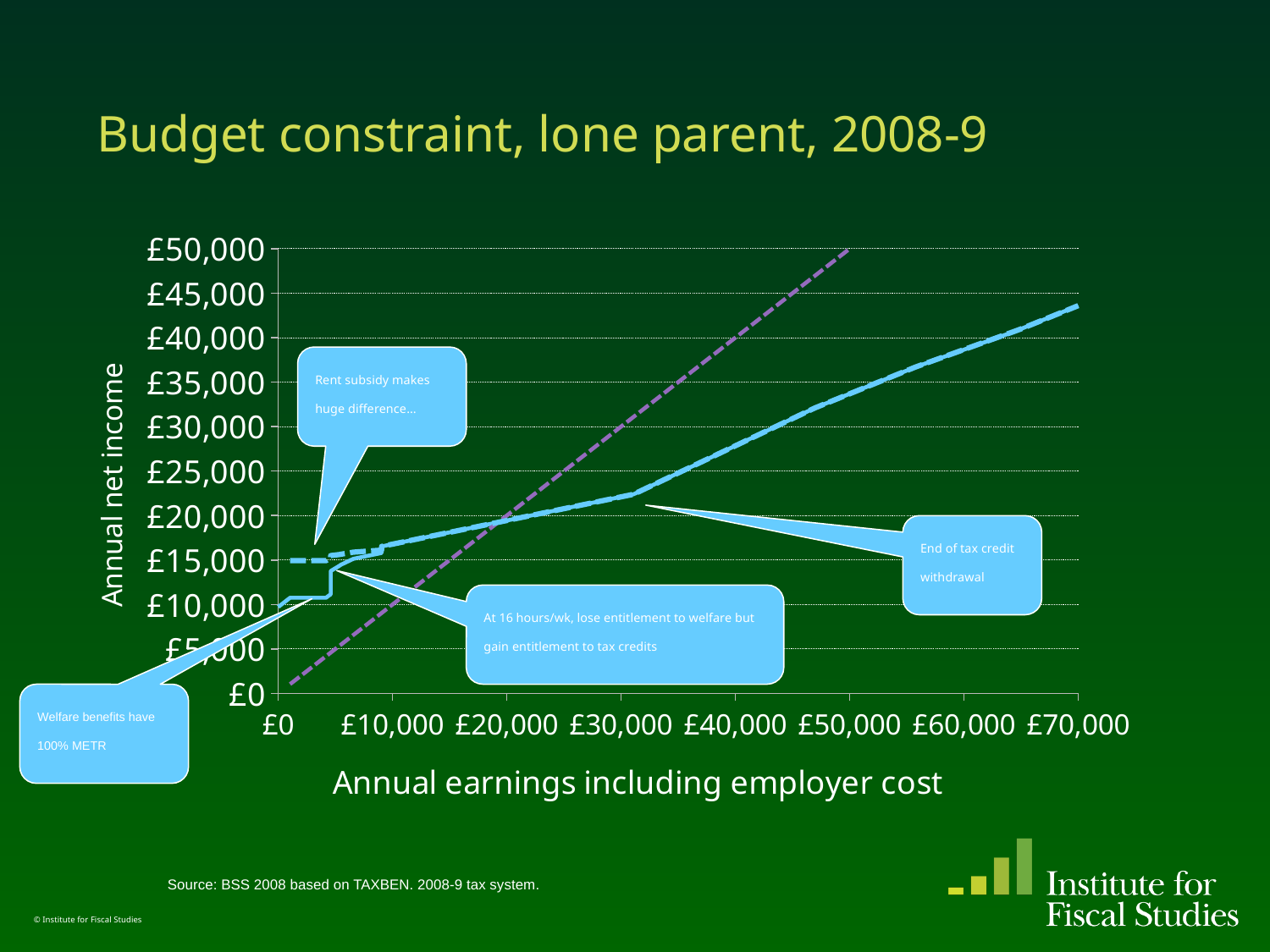
At £10,000 of annual earnings, which line is higher: the solid blue line or the dashed purple line? the solid blue line What is the title of the chart on the slide? Budget constraint, lone parent, 2008-9 Does the solid blue line rise or fall as annual earnings increase along the x axis? rise What is the label of the vertical axis? Annual net income At £40,000 of annual earnings, which line is higher: the solid blue line or the dashed purple line? the dashed purple line How many lines are plotted on the chart? 3 What kind of chart is shown on the slide? line chart What is the highest value shown on the vertical axis? £50,000 Is the annual net income on the solid blue line at £70,000 of annual earnings greater or less than £40,000? greater Is the value of the dashed purple line at £40,000 of annual earnings greater or less than £35,000? greater